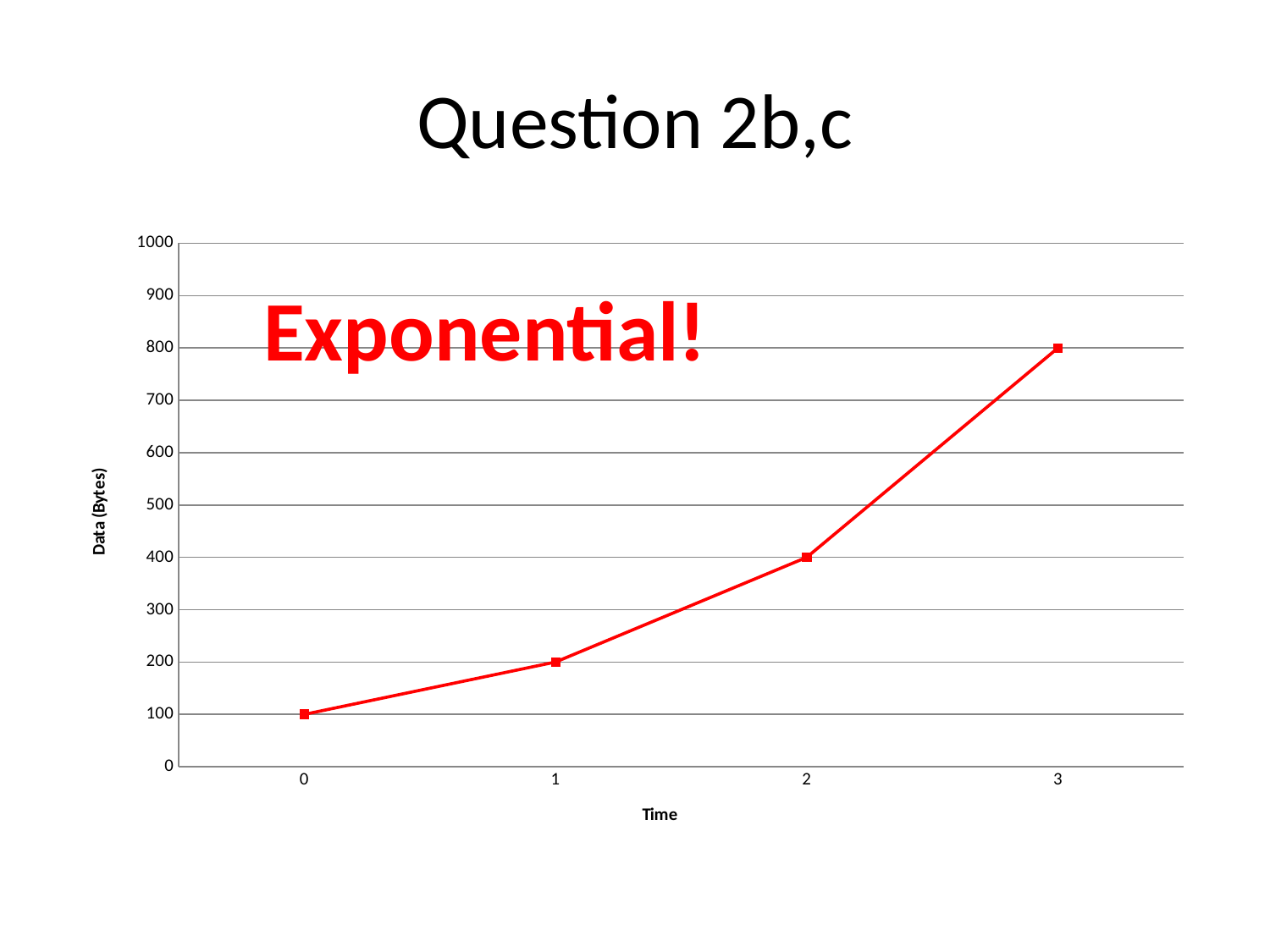
What is the difference in Data (Bytes) between Time 3 and Time 2? 400 What type of chart is shown on the slide? line chart What is the value of Data (Bytes) at Time 2? 400 Do the values rise or fall as Time increases? rise What is the label of the vertical axis? Data (Bytes) What is the value of Data (Bytes) at Time 1? 200 What is the value of Data (Bytes) at Time 0? 100 At which Time is the Data (Bytes) value lowest? 0 At which Time is the Data (Bytes) value highest? 3 What is the value of Data (Bytes) at Time 3? 800 Which has a larger Data (Bytes) value, Time 1 or Time 2? Time 2 How many data points are plotted on the line? 4